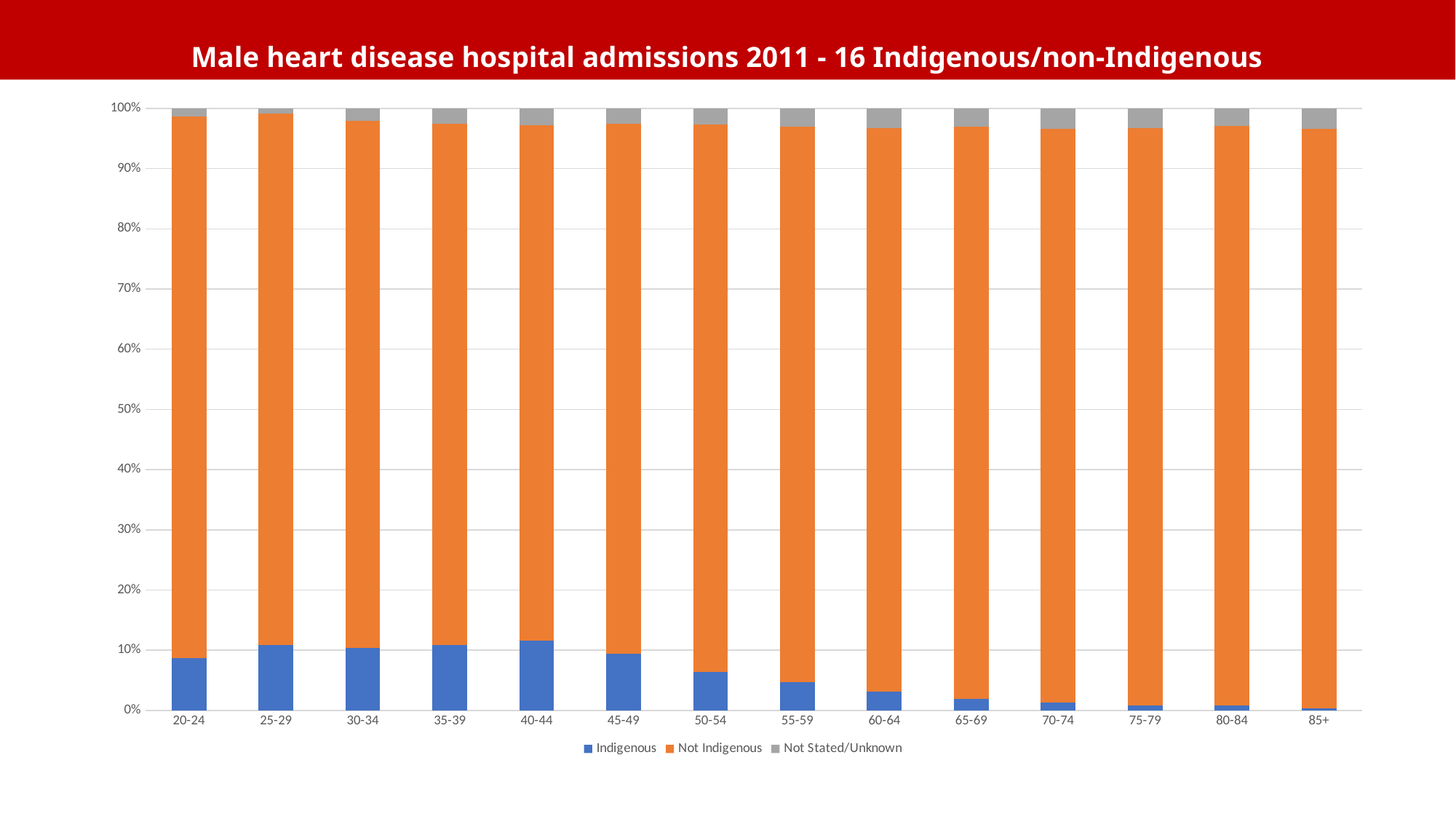
What is the title of the chart? Male heart disease hospital admissions 2011 - 16 Indigenous/non-Indigenous Which colour represents the Not Indigenous series? Orange How many series does the legend list? 3 How many age-group categories are shown on the x axis? 14 From the 40-44 age group onward, does the Indigenous share rise or fall as age increases? fall Is the Indigenous value for the 40-44 age group greater or less than 10%? greater Is the Indigenous value for the 20-24 age group greater or less than 10%? less Which is larger, the Indigenous share for 25-29 or for 70-74? 25-29 What kind of chart is shown on the slide? Stacked bar chart What is the total of the stacked bar for the 20-24 age group? 100% Is the Indigenous value for the 60-64 age group greater or less than 10%? less Which is larger, the Indigenous share for 40-44 or for 60-64? 40-44